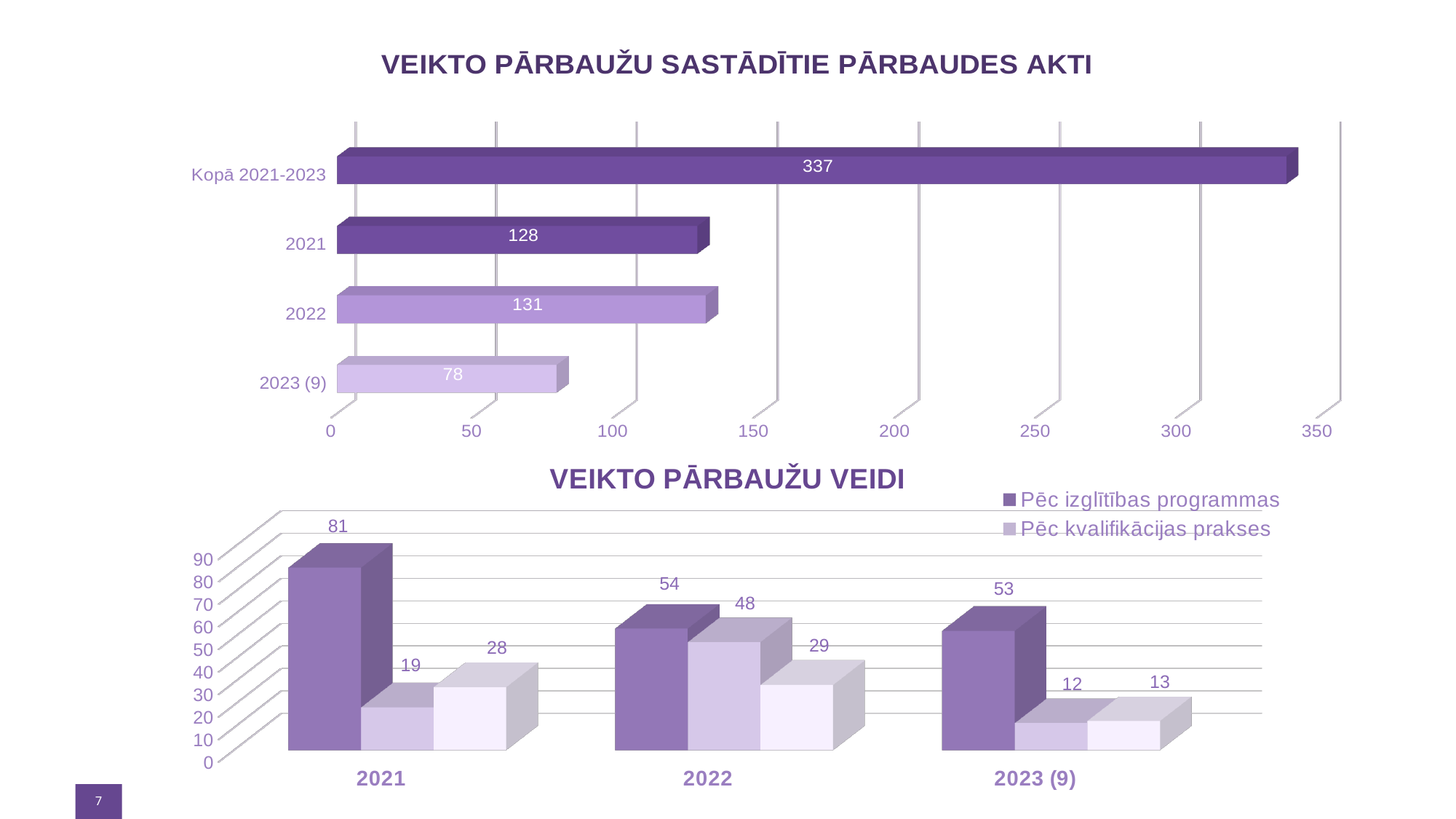
In the chart titled "VEIKTO PĀRBAUŽU SASTĀDĪTIE PĀRBAUDES AKTI", what is the difference between the values for 2022 and 2021? 3 In the chart titled "VEIKTO PĀRBAUŽU SASTĀDĪTIE PĀRBAUDES AKTI", how many categories are shown? 4 What kind of chart is the top chart titled "VEIKTO PĀRBAUŽU SASTĀDĪTIE PĀRBAUDES AKTI"? bar chart In the chart titled "VEIKTO PĀRBAUŽU VEIDI", what is the difference between Pēc izglītības programmas and Pēc kvalifikācijas prakses in 2023 (9)? 41 In the chart titled "VEIKTO PĀRBAUŽU VEIDI", what is the value for Pēc kvalifikācijas prakses in 2022? 48 In the chart titled "VEIKTO PĀRBAUŽU SASTĀDĪTIE PĀRBAUDES AKTI", which category has the lowest value? 2023 (9) In the chart titled "VEIKTO PĀRBAUŽU VEIDI", what is the value for Pēc izglītības programmas in 2021? 81 In the chart titled "VEIKTO PĀRBAUŽU SASTĀDĪTIE PĀRBAUDES AKTI", what is the value for Kopā 2021-2023? 337 In the chart titled "VEIKTO PĀRBAUŽU VEIDI", which year has the highest value for Pēc izglītības programmas? 2021 In the chart titled "VEIKTO PĀRBAUŽU VEIDI", how many series does the legend list? 2 In the chart titled "VEIKTO PĀRBAUŽU SASTĀDĪTIE PĀRBAUDES AKTI", what is the value for 2022? 131 In the chart titled "VEIKTO PĀRBAUŽU VEIDI", which is larger: Pēc izglītības programmas in 2022 or Pēc kvalifikācijas prakses in 2022? Pēc izglītības programmas